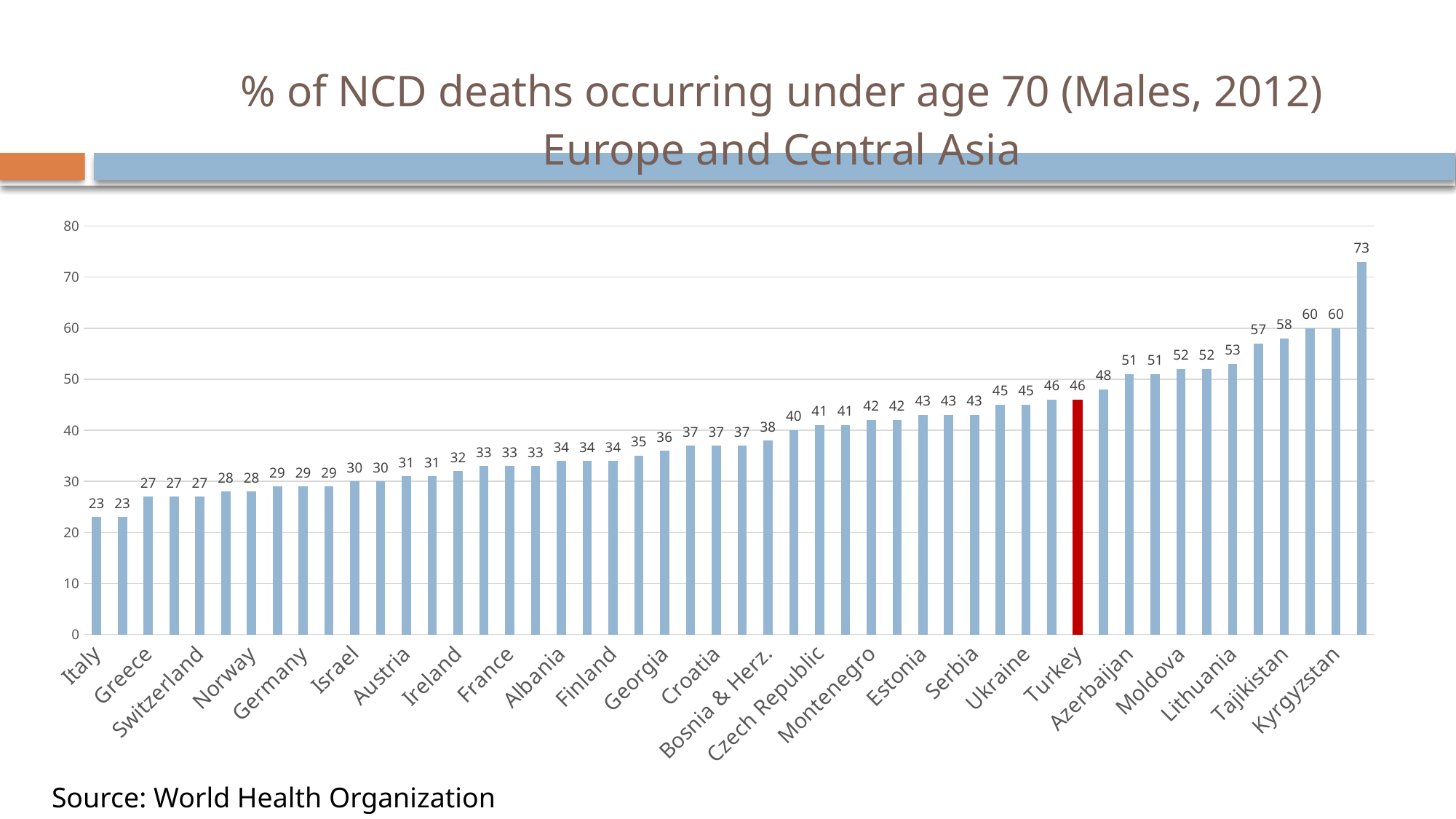
Which country is highlighted with a red bar? Turkey Which has a larger value, Turkey or Italy? Turkey What is the value for Italy? 23 What type of chart is shown on the slide? bar chart Do the values generally rise or fall from left to right along the x axis? rise What is the source cited for the chart? World Health Organization What is the highest value shown in the chart? 73 Is the value for Turkey greater or less than 40? greater What is the value for Turkey, the red bar? 46 What is the difference between the value for Turkey and the value for Italy? 23 What is the lowest value shown in the chart? 23 Is the value for Italy greater or less than 30? less